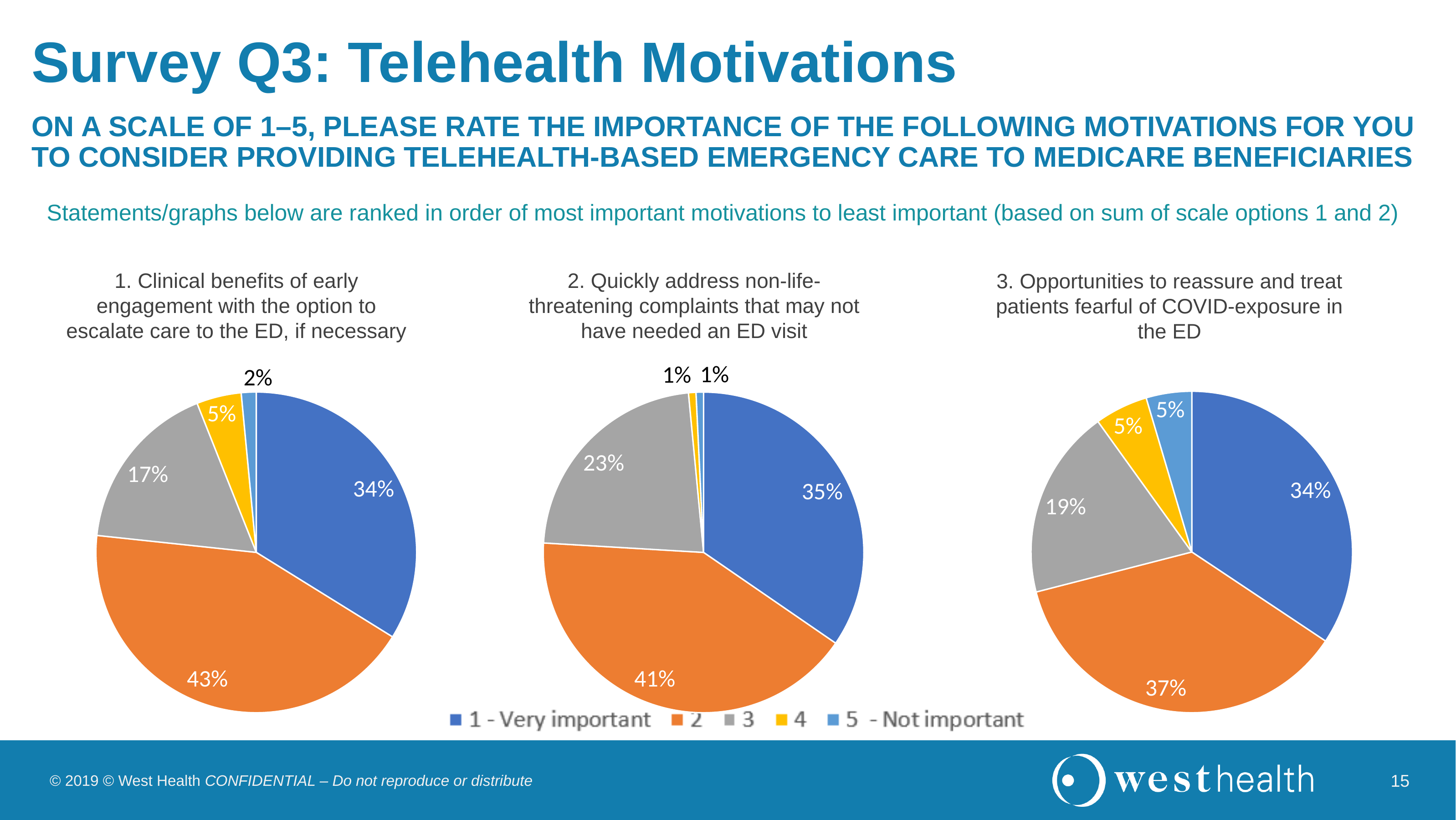
Which colour represents the rating 1 - Very important in the legend? Blue In the first pie chart (Clinical benefits of early engagement), what share of respondents rated the motivation 1 - Very important? 34% In the first pie chart (Clinical benefits of early engagement), which rating has the smallest share? 5 - Not important How many series does the legend list? 5 In the third pie chart (Opportunities to reassure and treat patients fearful of COVID-exposure), what is the difference between the share rating 2 and the share rating 1 - Very important? 3 percentage points In the first pie chart (Clinical benefits of early engagement), what share of respondents rated the motivation 2? 43% In the second pie chart (Quickly address non-life-threatening complaints), what share of respondents rated the motivation 3? 23% In the third pie chart (Opportunities to reassure and treat patients fearful of COVID-exposure), what share of respondents rated the motivation 5 - Not important? 5% What kind of charts are shown on the slide? Pie charts How many pie charts are on the slide? 3 In the first pie chart (Clinical benefits of early engagement), which is larger: the share rating 3 or the share rating 4? 3 In the second pie chart (Quickly address non-life-threatening complaints), which rating has the largest share? 2